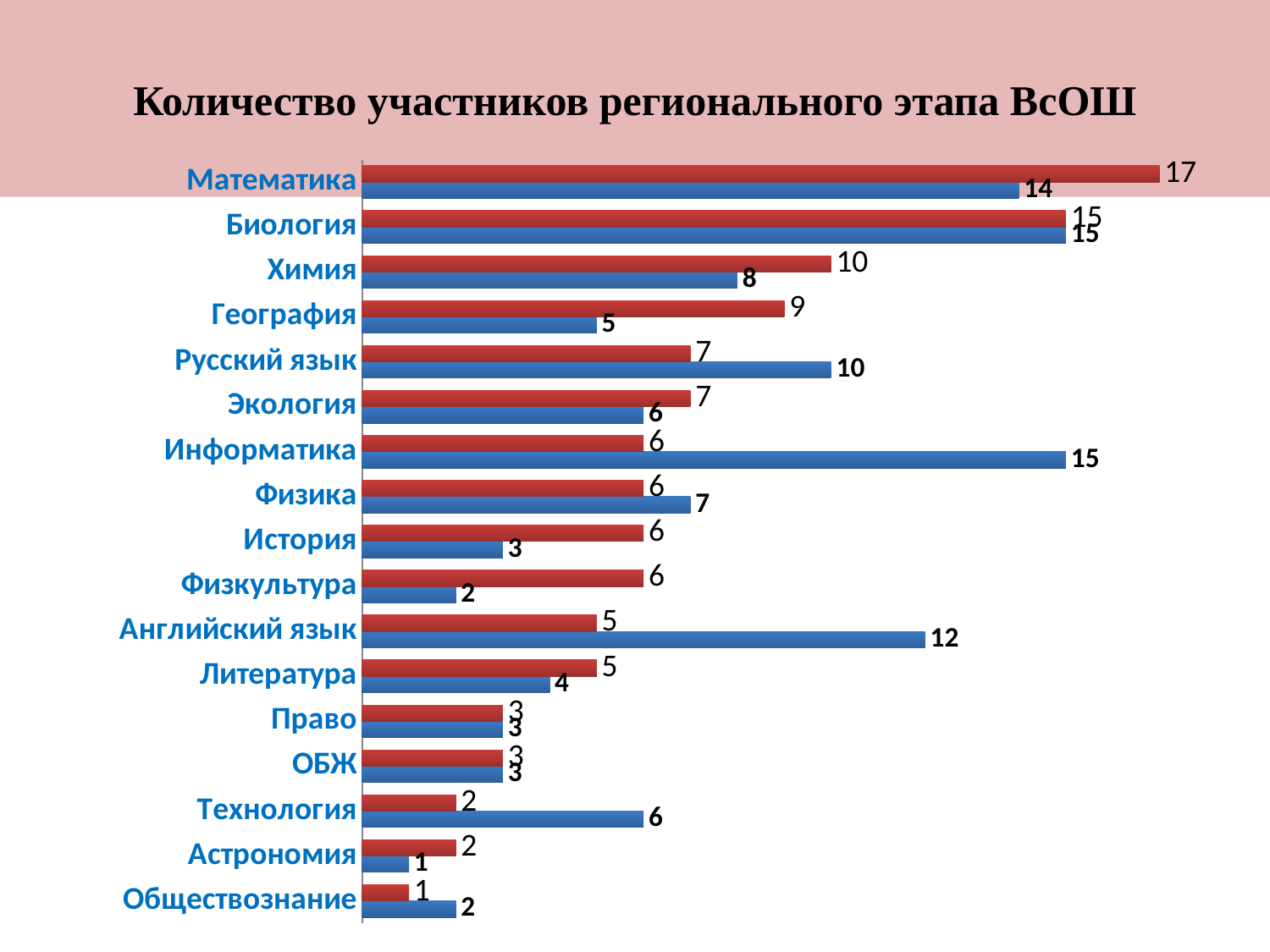
Which category has the highest value in the red series? Математика What is the title of the chart? Количество участников регионального этапа ВсОШ What is the difference between the red and blue bars for Информатика? 9 How many subject categories are shown on the chart? 17 What is the value of the red bar for География? 9 For Русский язык, which bar is larger, the red or the blue? blue What is the value of the blue bar for Английский язык? 12 What is the difference between the red bar for Математика and the blue bar for Математика? 3 What is the value of the blue bar for Информатика? 15 What is the value of the red bar for Математика? 17 What kind of chart is shown on the slide? bar chart Which category has the lowest value in the red series? Обществознание